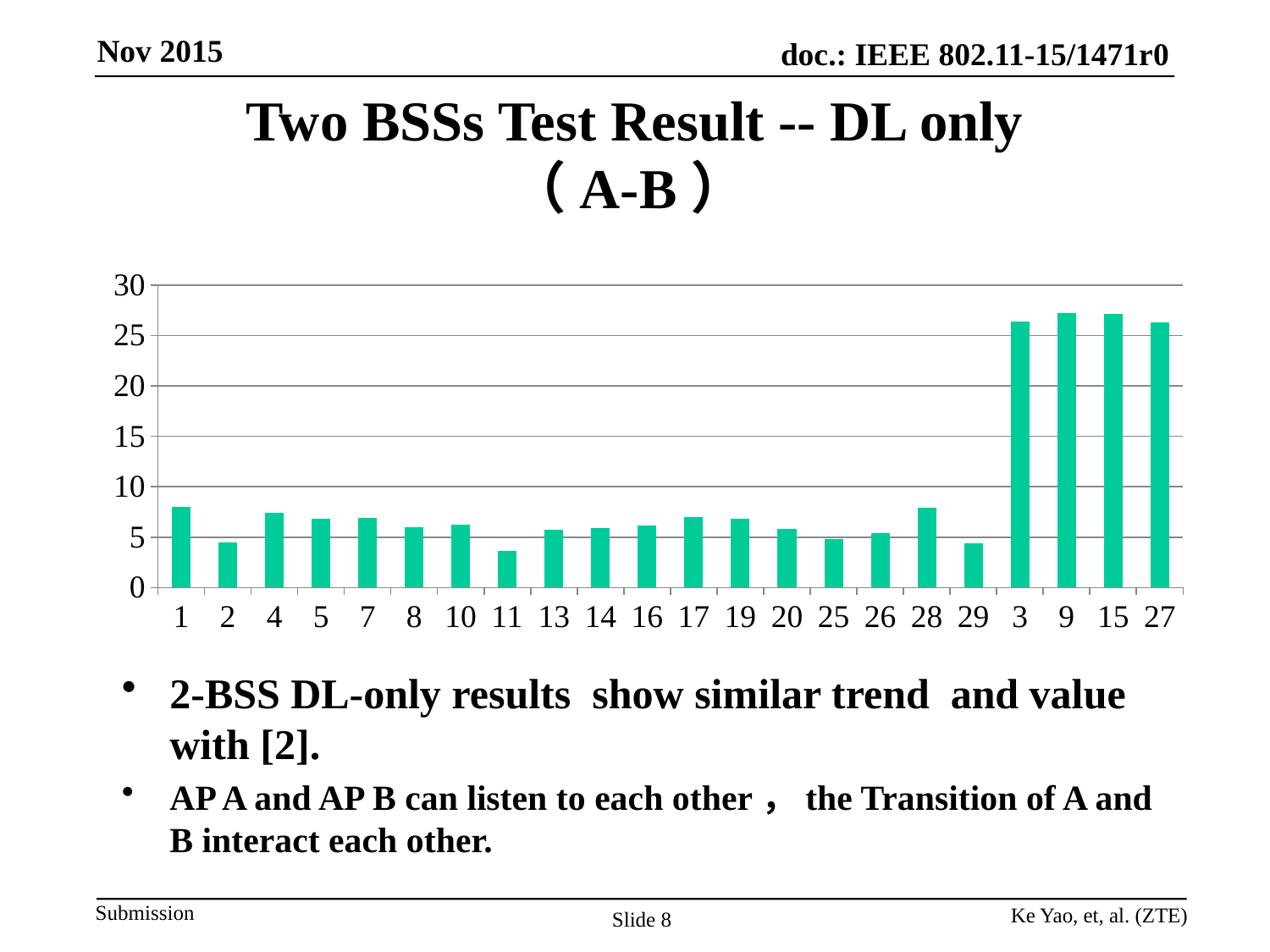
Is the value for category 28 greater or less than 10? less Is the value for category 1 greater or less than 5? greater What is the label of the last category on the x axis of the chart? 27 Is the value for category 9 greater or less than 20? greater What is the highest tick value shown on the y axis of the chart? 30 Which is larger, the value for category 1 or the value for category 2? 1 Which category has the lowest bar in the chart? 11 Which is larger, the value for category 3 or the value for category 1? 3 What kind of chart is shown on the slide? bar chart How many categories are plotted along the x axis of the chart? 22